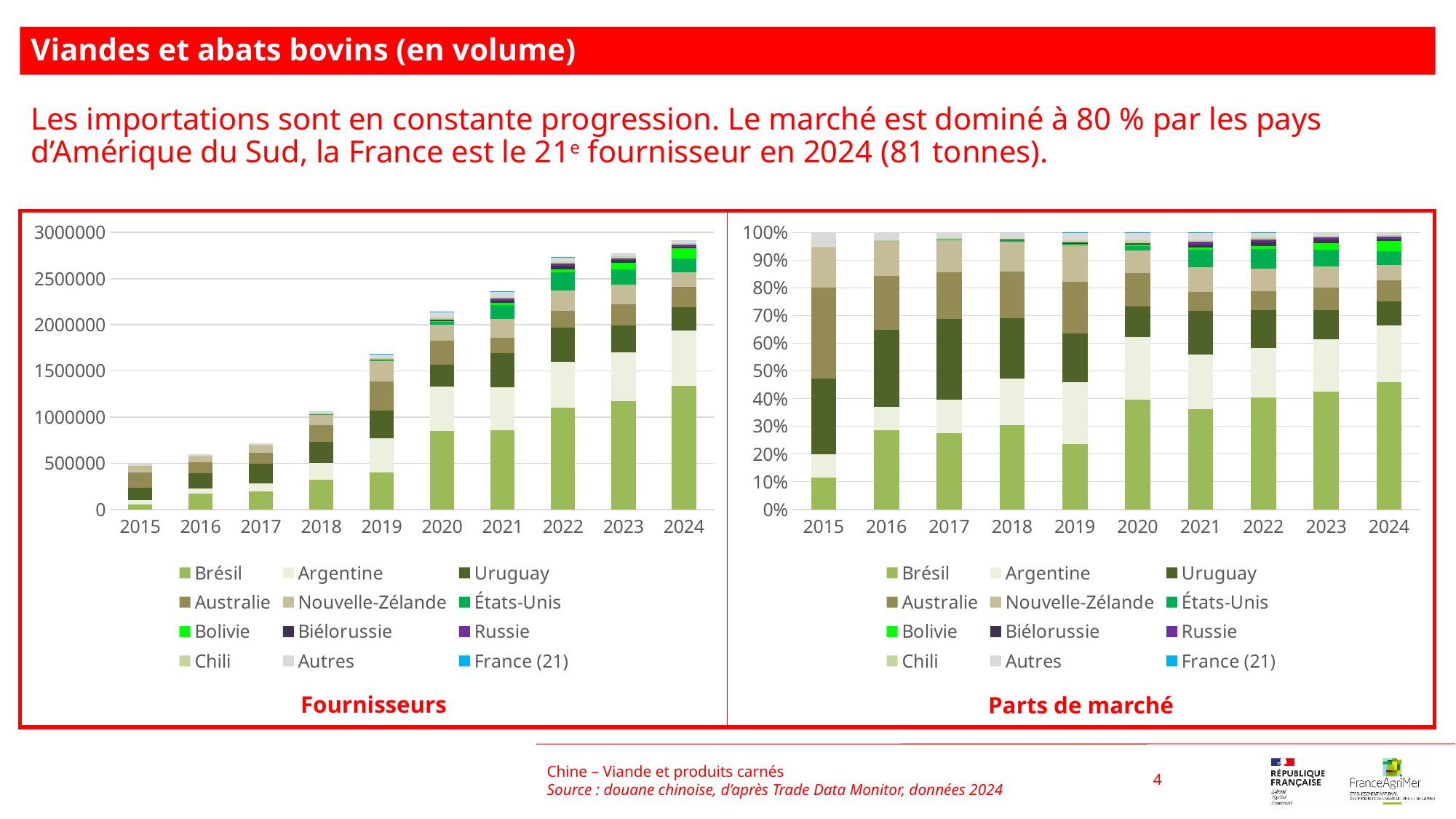
In the 'Fournisseurs' chart, which year has the highest total bar? 2024 In the 'Parts de marché' chart, is the share of Brésil in 2024 greater or less than 40%? greater How many series does the legend of the 'Parts de marché' chart list? 12 In the 'Fournisseurs' chart, which year has the lowest total bar? 2015 What is the title shown under the right-hand chart? Parts de marché In the 'Fournisseurs' chart, is the total bar for 2022 larger or smaller than the total bar for 2021? larger How many years are shown on the x axis of the 'Fournisseurs' chart? 10 In the 'Parts de marché' chart, is the share of Brésil in 2015 greater or less than 20%? less In the 'Fournisseurs' chart, do the total bar heights rise or fall from 2015 to 2024? Rise What kind of chart is the 'Fournisseurs' chart on the left? Stacked bar chart In the 'Fournisseurs' chart, is the total for 2019 greater or less than 1500000? greater